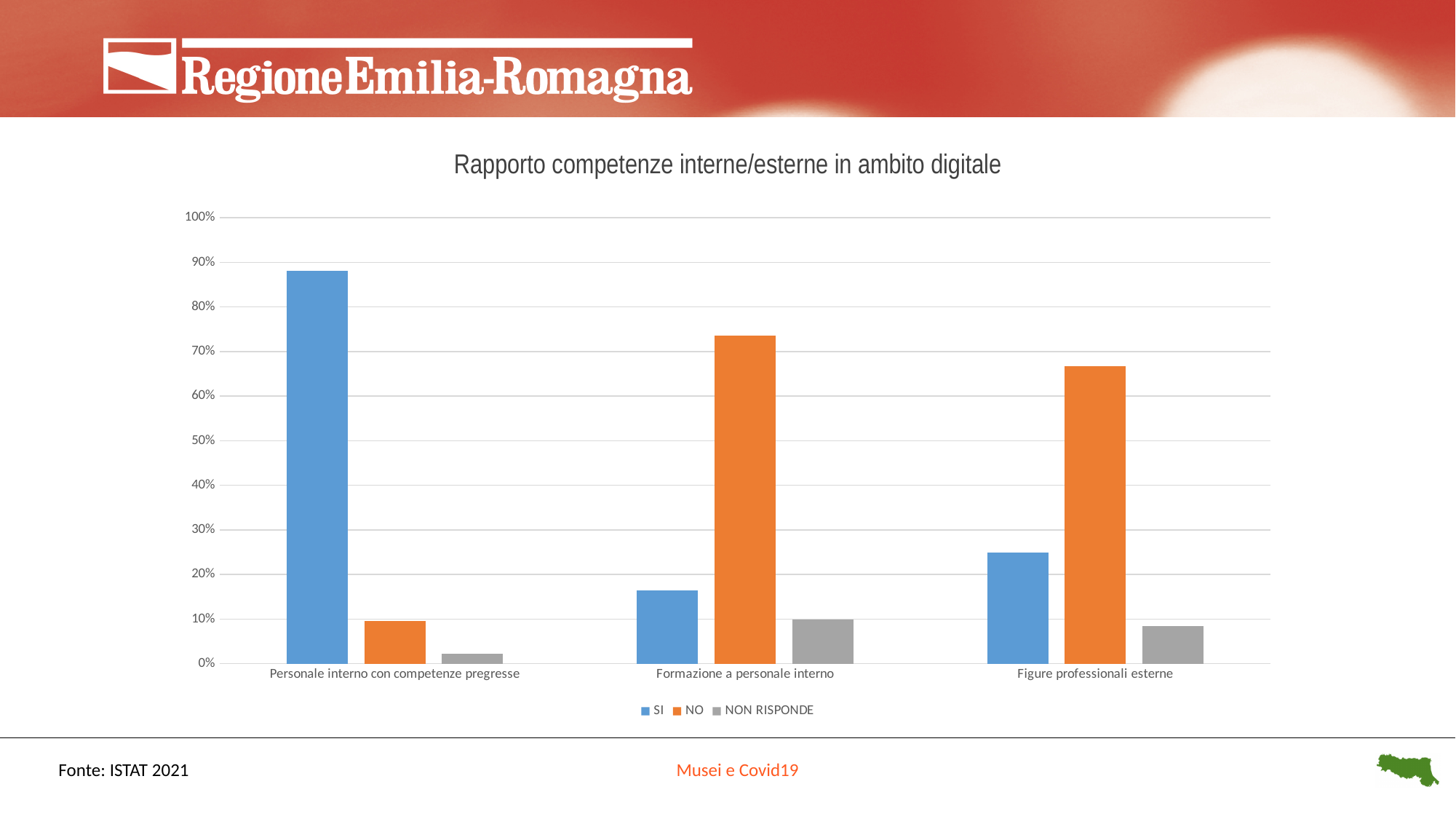
Is the NO value for Figure professionali esterne greater or less than 70%? less How many series does the legend list? 3 For Figure professionali esterne, which is larger: the SI value or the NO value? NO Which series is shown in orange in the legend? NO What kind of chart is shown on the slide? bar chart How many categories are shown on the x axis? 3 Is the SI value for Personale interno con competenze pregresse greater or less than 80%? greater Which category has the highest SI value? Personale interno con competenze pregresse Is the SI value for Formazione a personale interno greater or less than 20%? less What is the title of the chart? Rapporto competenze interne/esterne in ambito digitale Which category has the lowest NON RISPONDE value? Personale interno con competenze pregresse Which category has the highest NO value? Formazione a personale interno